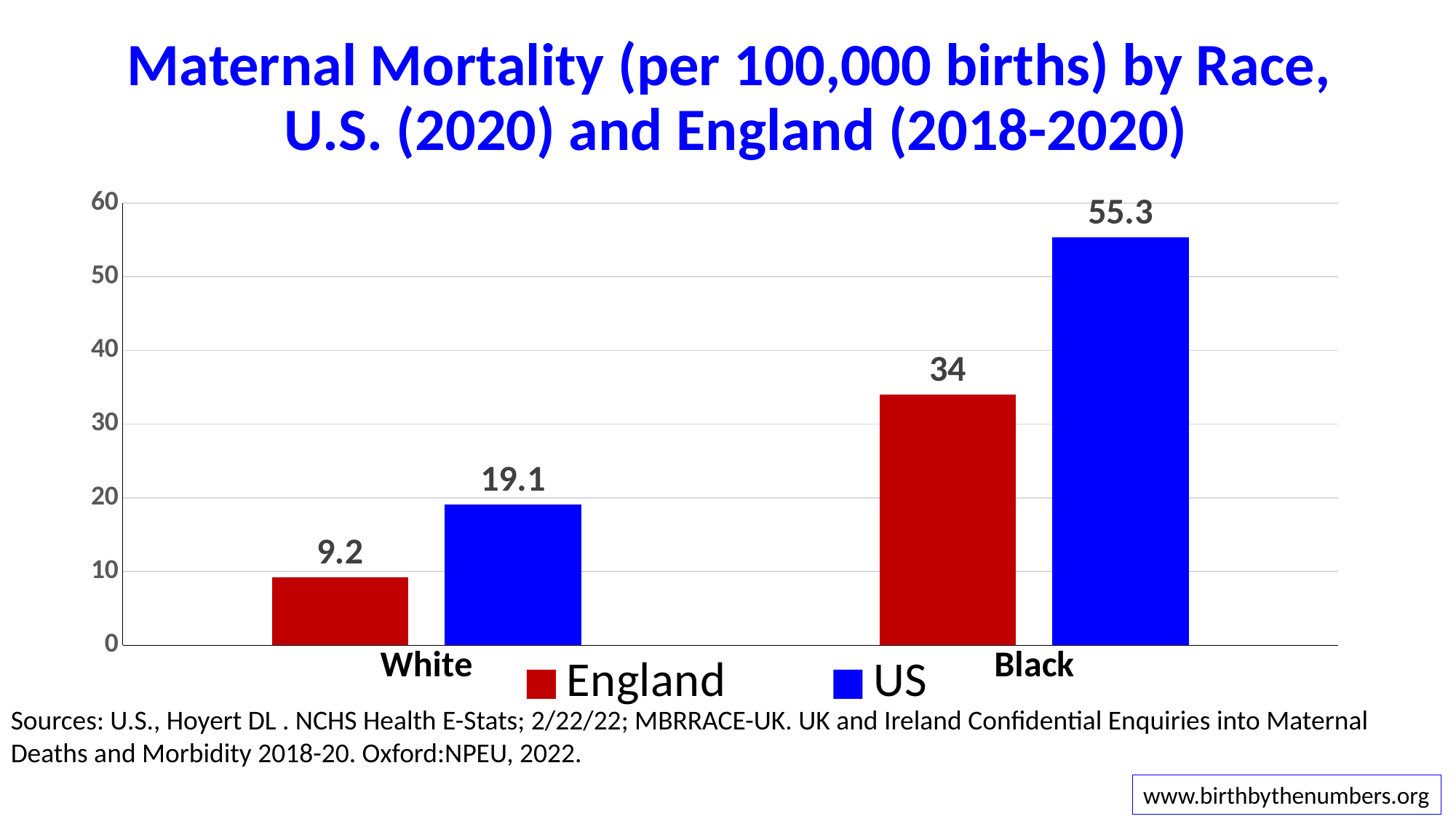
Which is larger: the England rate for Black women or the US rate for White women? England rate for Black women How many race categories are shown on the x axis? 2 How many series does the legend list? 2 What kind of chart is shown on the slide? Bar chart What is the difference between the US and England maternal mortality rates for Black women? 21.3 Which bar shows the highest maternal mortality rate? US, Black What is the maternal mortality rate for White women in England? 9.2 Which bar shows the lowest maternal mortality rate? England, White What is the difference between the US and England maternal mortality rates for White women? 9.9 What is the maternal mortality rate for White women in the US? 19.1 What is the maternal mortality rate for Black women in England? 34 What is the maternal mortality rate for Black women in the US? 55.3